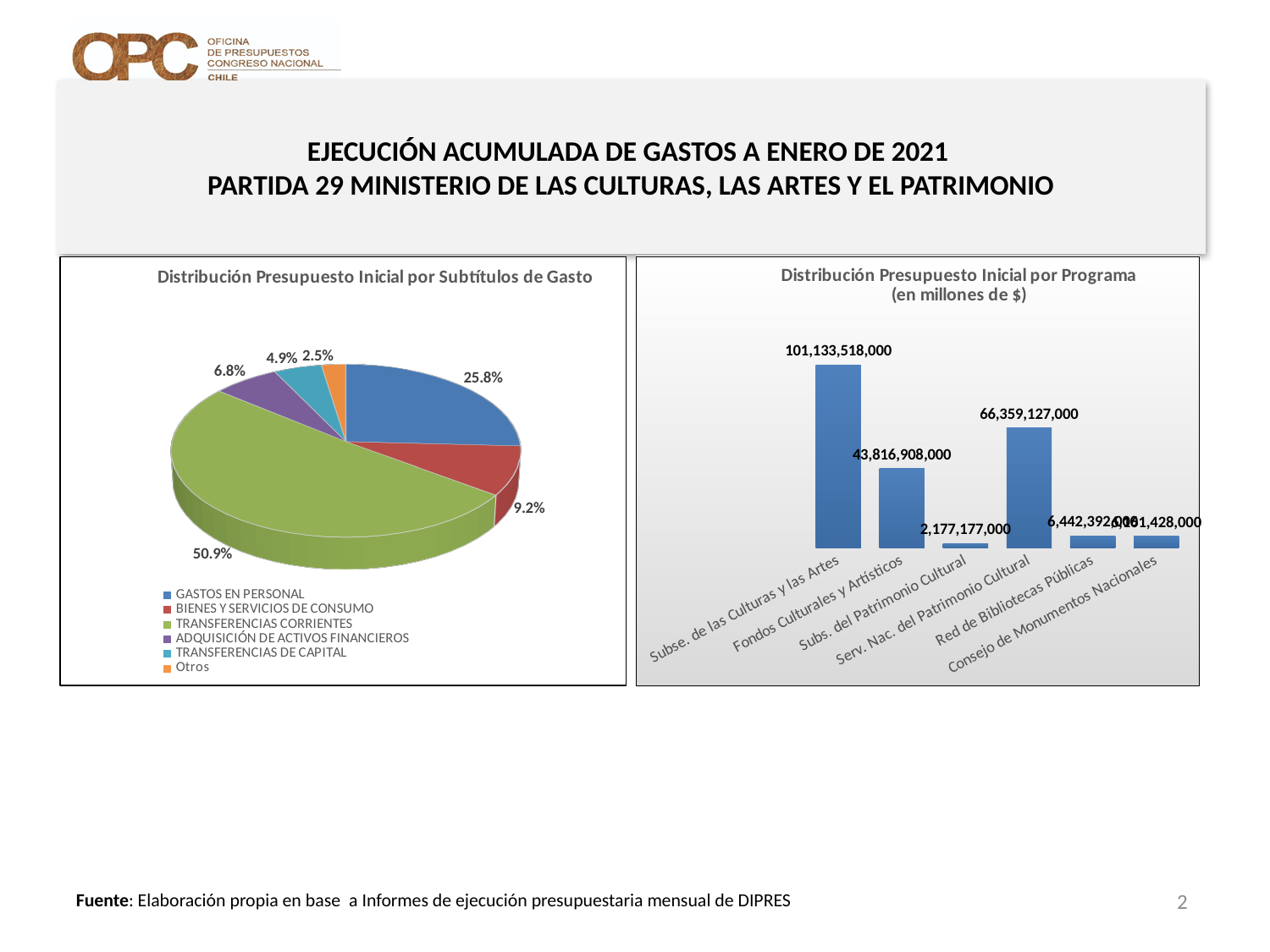
In the pie chart on the left, which category has the smallest slice? Otros In the pie chart 'Distribución Presupuesto Inicial por Subtítulos de Gasto', what share is TRANSFERENCIAS CORRIENTES? 50.9% How many categories does the legend of the pie chart on the left list? 6 In the bar chart 'Distribución Presupuesto Inicial por Programa', what is the value for Subse. de las Culturas y las Artes? 101,133,518,000 In the pie chart on the left, which category has the largest slice? TRANSFERENCIAS CORRIENTES In the bar chart on the right, what is the difference between Subse. de las Culturas y las Artes and Serv. Nac. del Patrimonio Cultural? 34,774,391,000 In the bar chart on the right, which program has the lowest value? Subs. del Patrimonio Cultural In the bar chart on the right, which is larger: Fondos Culturales y Artísticos or Serv. Nac. del Patrimonio Cultural? Serv. Nac. del Patrimonio Cultural What kind of chart is 'Distribución Presupuesto Inicial por Subtítulos de Gasto'? Pie chart In the pie chart on the left, what is the difference in percentage points between GASTOS EN PERSONAL and BIENES Y SERVICIOS DE CONSUMO? 16.6% In the pie chart 'Distribución Presupuesto Inicial por Subtítulos de Gasto', what percentage is shown for GASTOS EN PERSONAL? 25.8% In the bar chart on the right, which program has the highest value? Subse. de las Culturas y las Artes